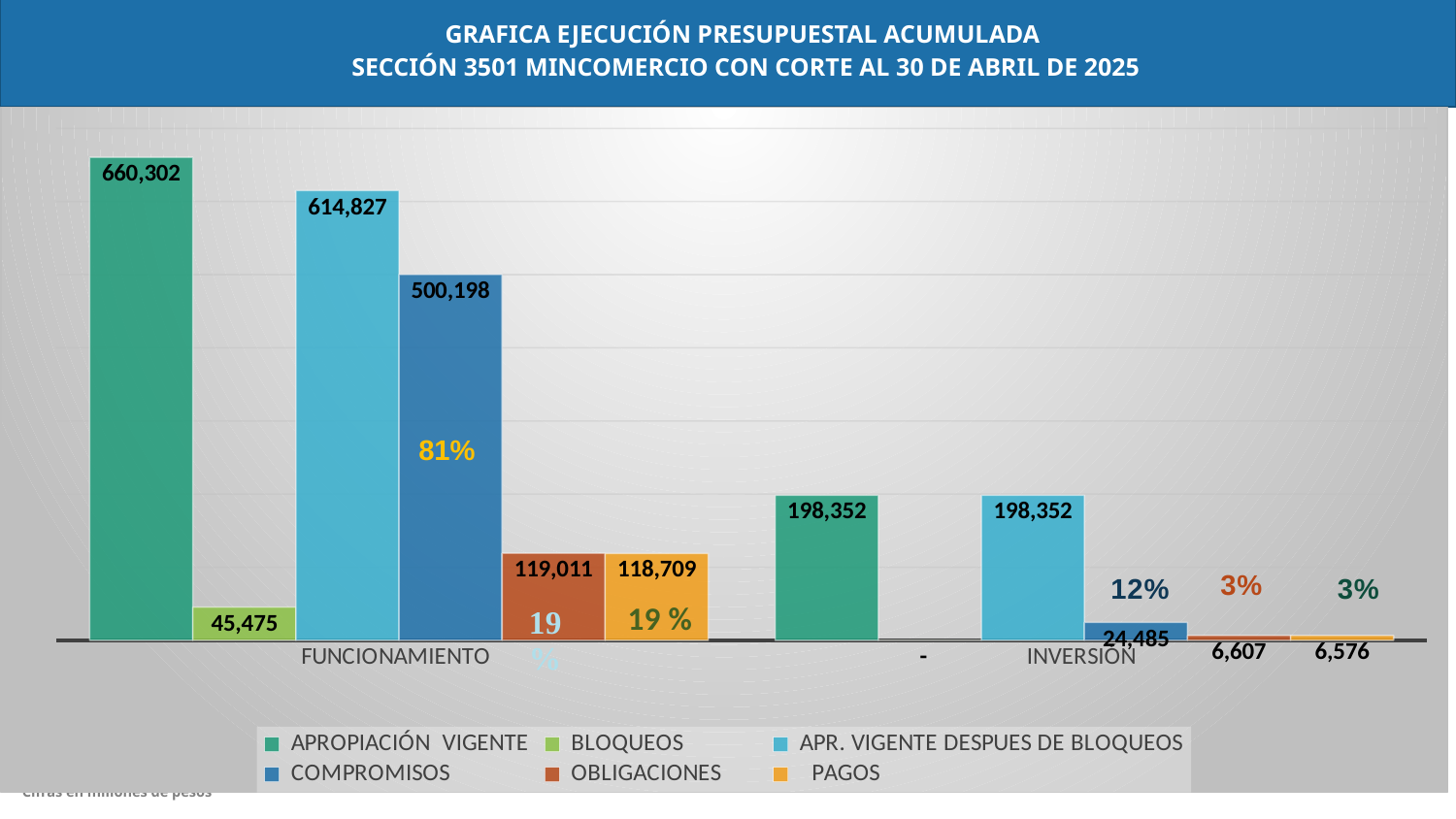
What is the value of PAGOS for INVERSIÓN? 6,576 What is the difference between APROPIACIÓN VIGENTE and APR. VIGENTE DESPUES DE BLOQUEOS for FUNCIONAMIENTO? 45,475 Which is larger: COMPROMISOS for FUNCIONAMIENTO or APROPIACIÓN VIGENTE for INVERSIÓN? COMPROMISOS for FUNCIONAMIENTO Which series has the highest value for FUNCIONAMIENTO? APROPIACIÓN VIGENTE What is the value of APR. VIGENTE DESPUES DE BLOQUEOS for FUNCIONAMIENTO? 614,827 What is the value of BLOQUEOS for FUNCIONAMIENTO? 45,475 What kind of chart is shown on the slide? Bar chart What is the difference between OBLIGACIONES and PAGOS for FUNCIONAMIENTO? 302 What is the value of APROPIACIÓN VIGENTE for FUNCIONAMIENTO? 660,302 What is the value of COMPROMISOS for INVERSIÓN? 24,485 How many series does the legend list? 6 Which series has the lowest value for INVERSIÓN among those with a labelled bar? PAGOS